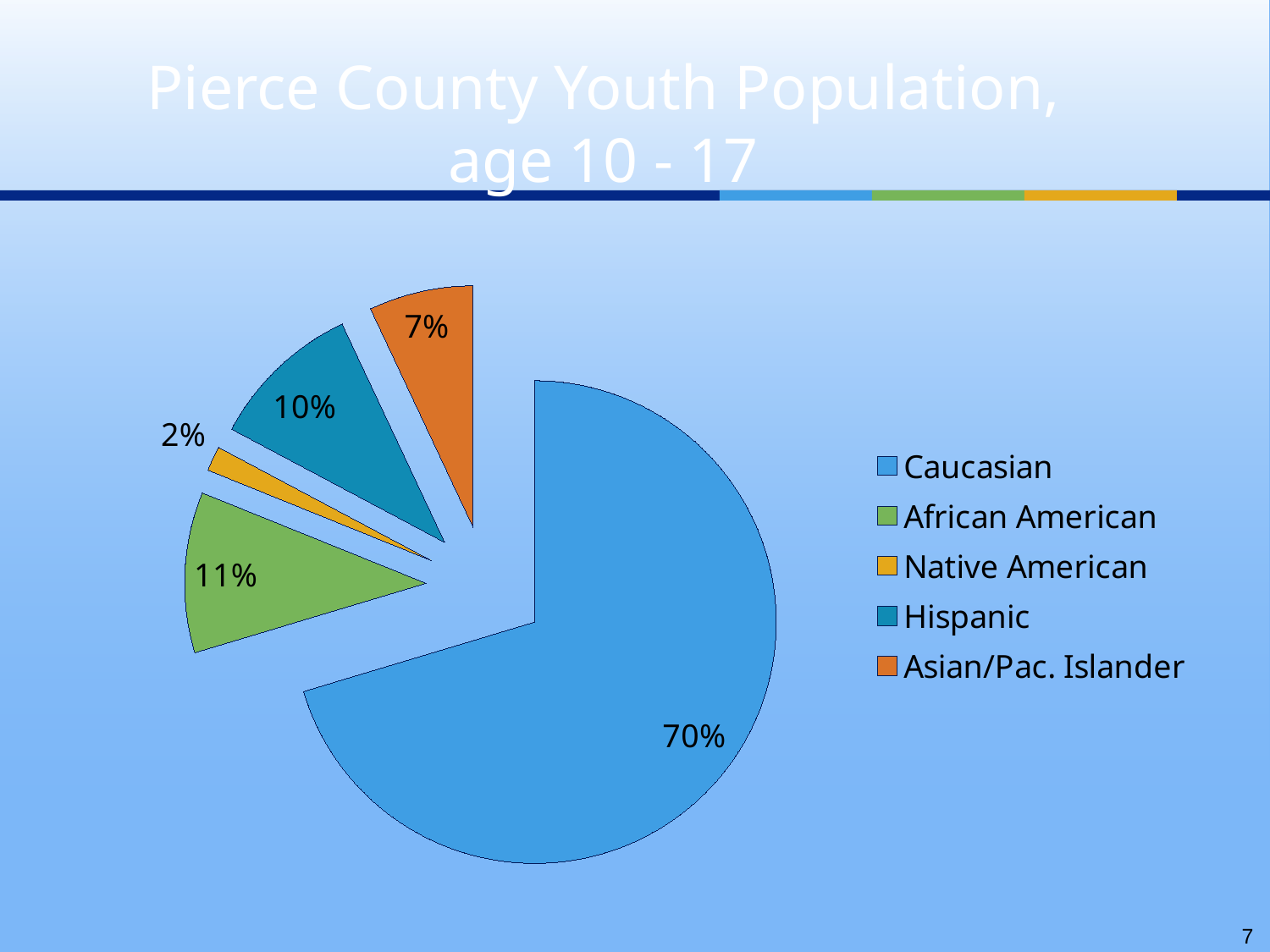
Which category has the largest slice of the pie? Caucasian Which is larger, the Hispanic slice or the Asian/Pac. Islander slice? Hispanic How many categories does the pie chart show? 5 What share of the pie is Asian/Pac. Islander? 7% What kind of chart is shown on the slide? pie chart What share of the pie is African American? 11% What share of the pie is Native American? 2% What is the difference in percentage points between the Caucasian and African American slices? 59 What is the title of the slide containing the chart? Pierce County Youth Population, age 10 - 17 Which category has the smallest slice of the pie? Native American